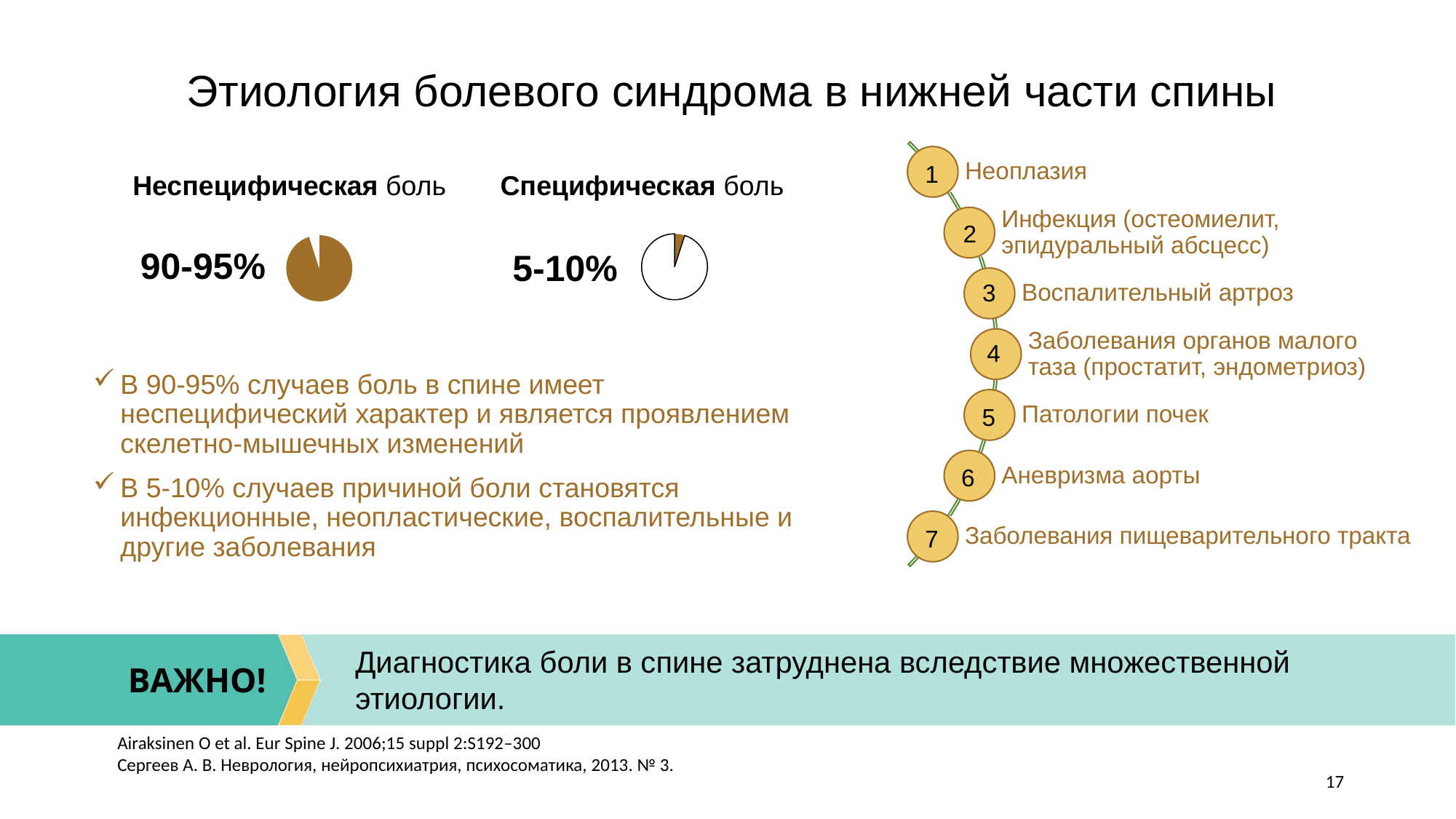
Is the share for Специфическая боль greater or less than 50%? less What share is shown for Неспецифическая боль? 90-95% Which of the two pie charts shows the larger share: Неспецифическая боль or Специфическая боль? Неспецифическая боль Which category has the largest share on the slide? Неспецифическая боль What kind of chart is used to show the share of non-specific pain (Неспецифическая боль)? pie chart What colour is the filled portion of the pie chart for Неспецифическая боль? brown How many pie charts are shown on the slide? 2 What is the title of the slide containing the pie charts? Этиология болевого синдрома в нижней части спины Which category has the smallest share on the slide? Специфическая боль What share is shown for Специфическая боль? 5-10% Is the share for Неспецифическая боль greater or less than 50%? greater